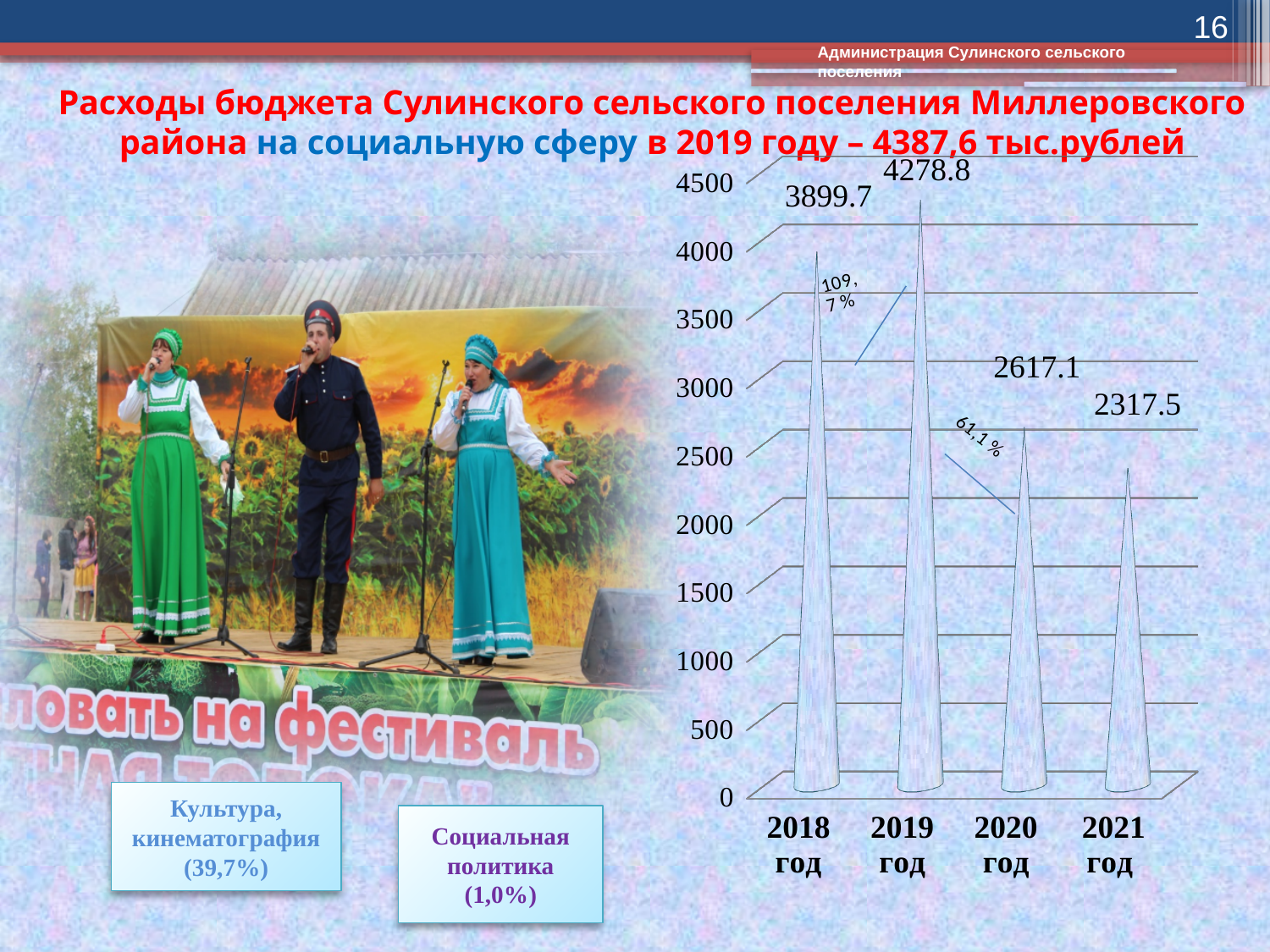
What is the value for 2021 год? 2317.5 Do the values rise or fall from 2019 год to 2021 год? fall What is the difference between the values for 2020 год and 2021 год? 299.6 What kind of chart is this? bar chart Which year has the lowest value? 2021 год Which is larger, the value for 2018 год or the value for 2020 год? 2018 год What is the difference between the values for 2019 год and 2018 год? 379.1 How many years are shown on the x axis? 4 What is the value for 2019 год? 4278.8 Which year has the highest value? 2019 год What is the value for 2020 год? 2617.1 What is the value for 2018 год? 3899.7